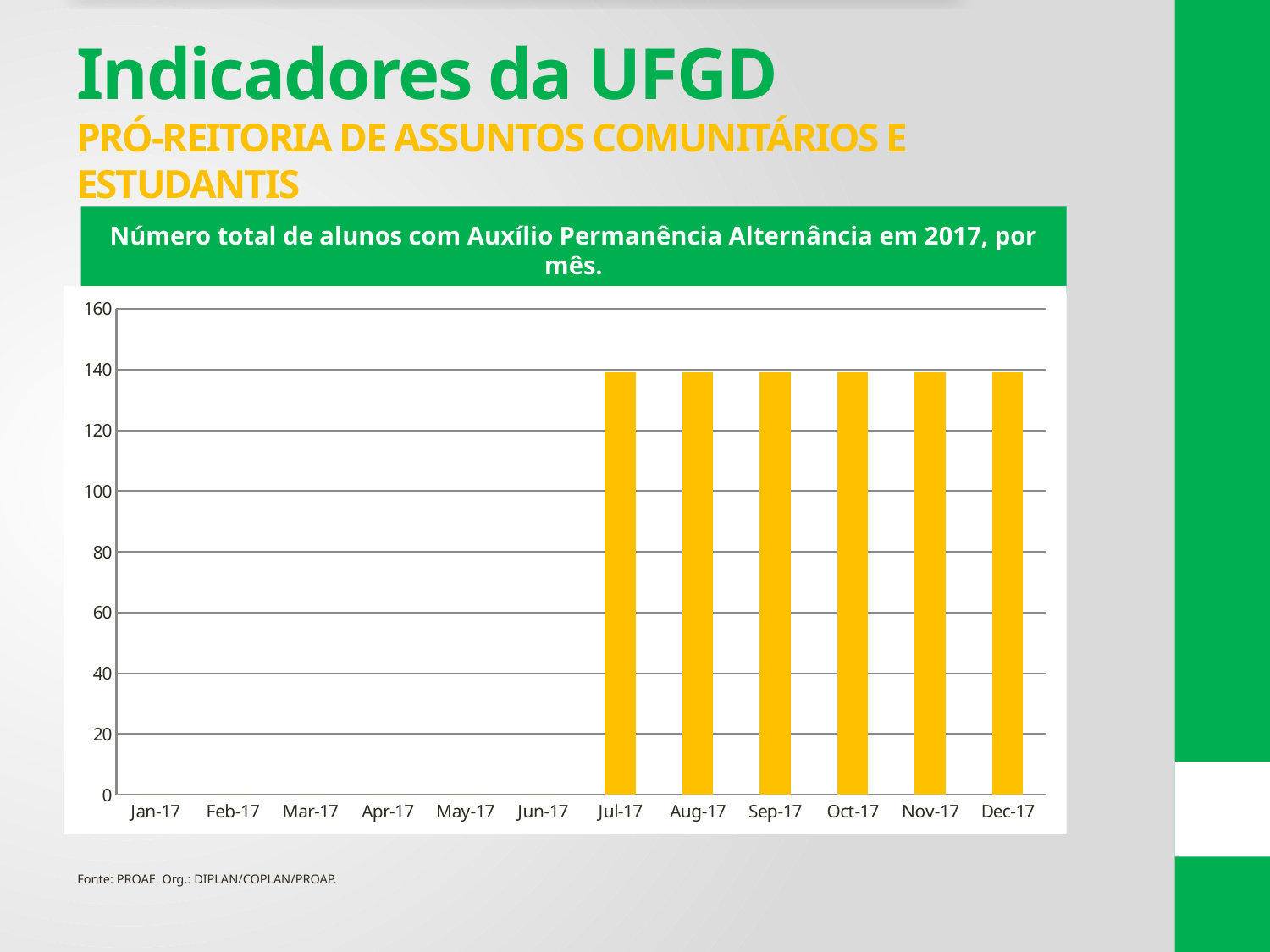
Is the value for Sep-17 greater or less than 160? less Which is larger, the value for Mar-17 or the value for Nov-17? Nov-17 In which month does the first visible bar appear on the chart? Jul-17 What kind of chart is shown on the slide? bar chart Is the value for Oct-17 greater or less than 80? greater What is the title of the chart? Número total de alunos com Auxílio Permanência Alternância em 2017, por mês. Is the value for Jul-17 greater or less than 120? greater How many months on the chart have a visible bar? 6 How many months are shown on the x axis of the chart? 12 What is the highest value shown on the y axis of the chart? 160 Which is larger, the value for Jul-17 or the value for Jan-17? Jul-17